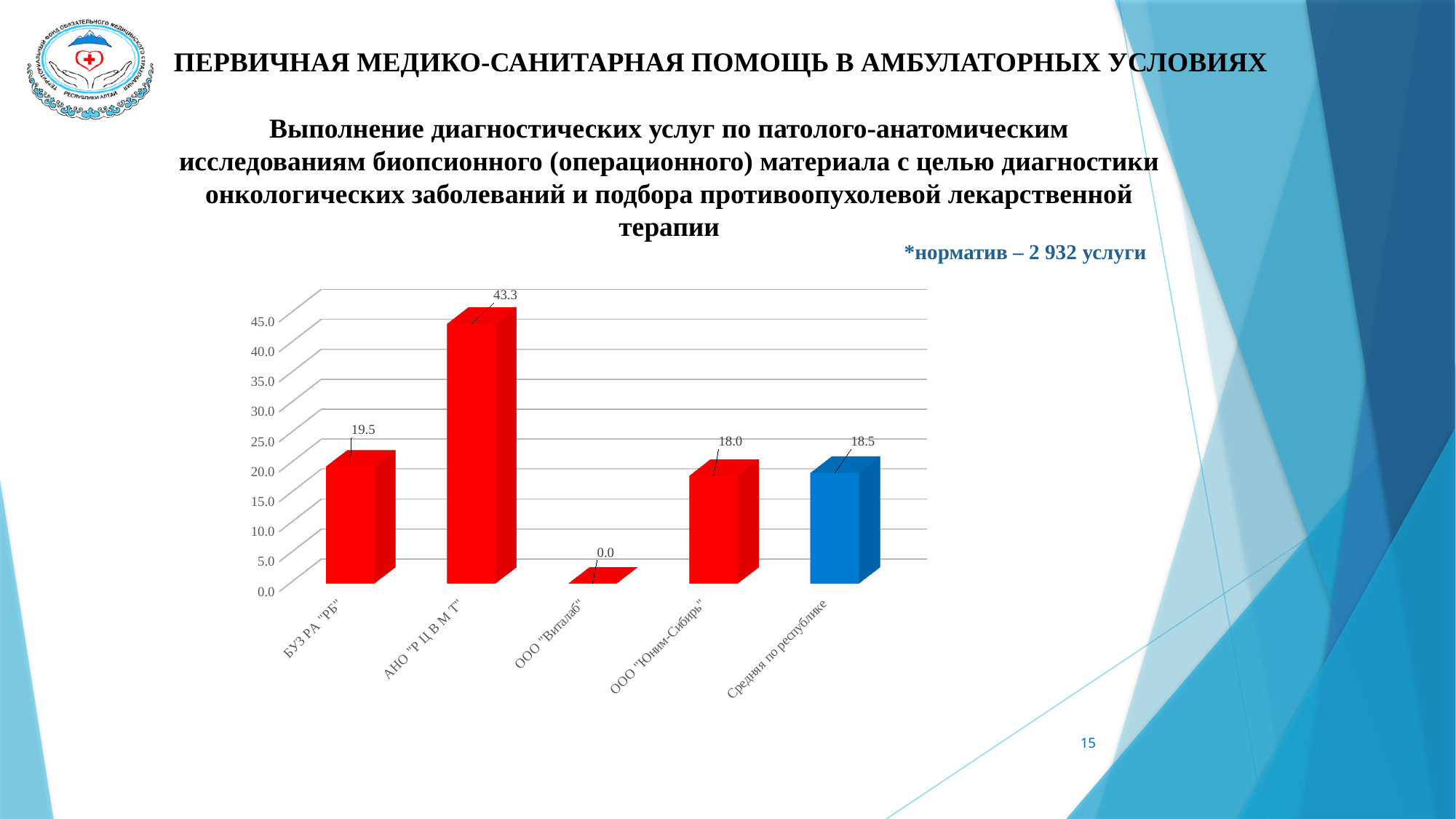
How many categories are shown on the chart? 5 Which category has the lowest value? ООО "Виталаб" What kind of chart is shown on the slide? Bar chart What is the value for ООО "Юним-Сибирь"? 18.0 What is the value for Средняя по республике? 18.5 What is the value for АНО "Р Ц В М Т"? 43.3 What is the value for ООО "Виталаб"? 0.0 Which category has the highest value? АНО "Р Ц В М Т" Which is larger, the value for БУЗ РА "РБ" or the value for Средняя по республике? БУЗ РА "РБ" What is the value for БУЗ РА "РБ"? 19.5 Which bar is coloured blue rather than red? Средняя по республике What is the difference between the values for АНО "Р Ц В М Т" and БУЗ РА "РБ"? 23.8